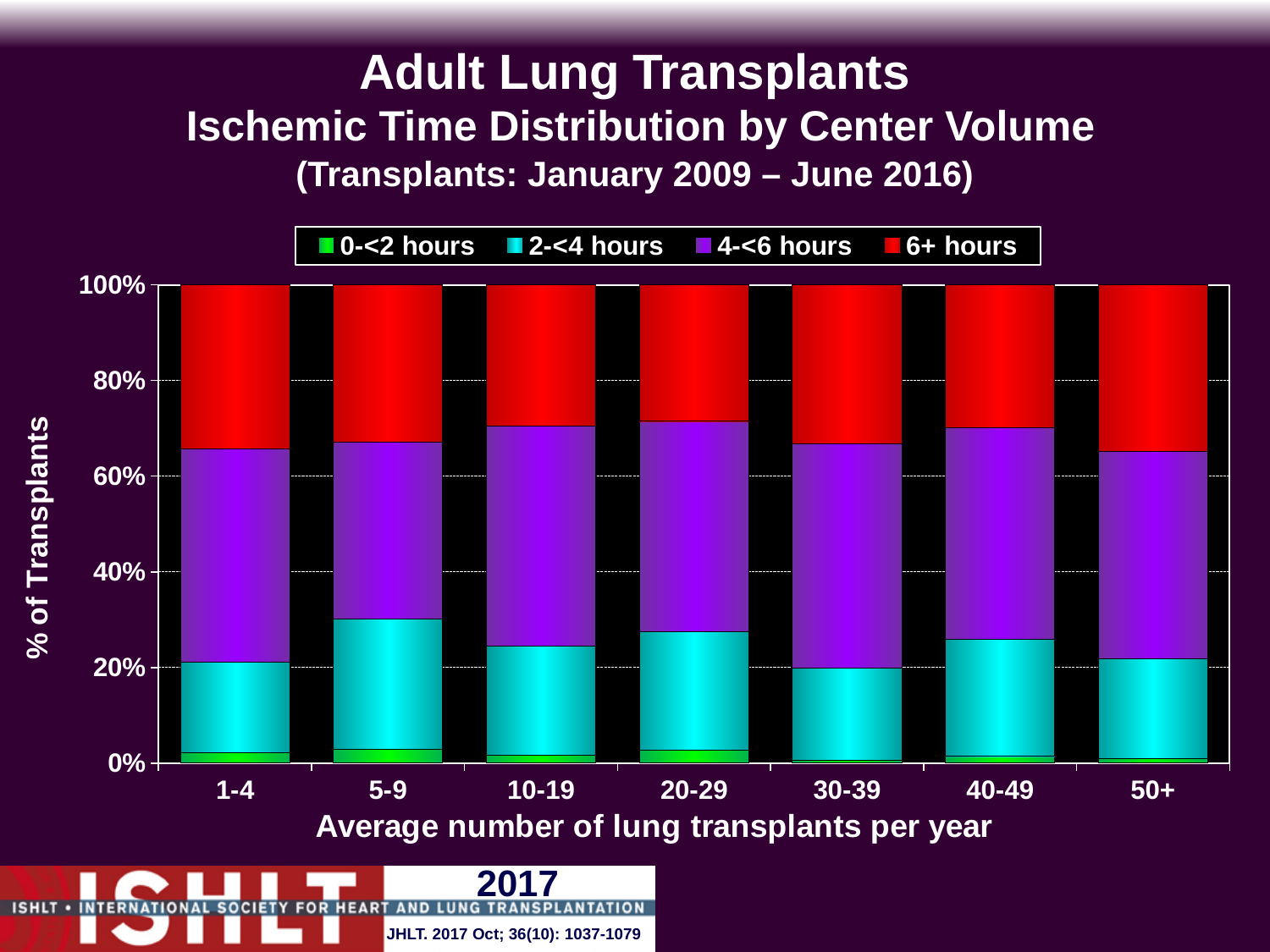
What kind of chart is shown on the slide? Stacked bar chart Is the combined share of transplants with ischemic time under 4 hours for the 10-19 category greater or less than 40%? less Which category has the larger 0-<2 hours segment, 5-9 or 30-39? 5-9 What is the label of the x axis? Average number of lung transplants per year Is the combined share of transplants with ischemic time under 4 hours for the 5-9 category greater or less than 20%? greater Which category has the larger 2-<4 hours segment, 5-9 or 30-39? 5-9 Which colour represents the 6+ hours series in the legend? Red How many center volume categories are shown along the x axis? 7 Is the combined share of transplants with ischemic time under 6 hours for the 50+ category greater or less than 60%? greater Which category has the larger 6+ hours segment, 50+ or 10-19? 50+ How many series does the legend list? 4